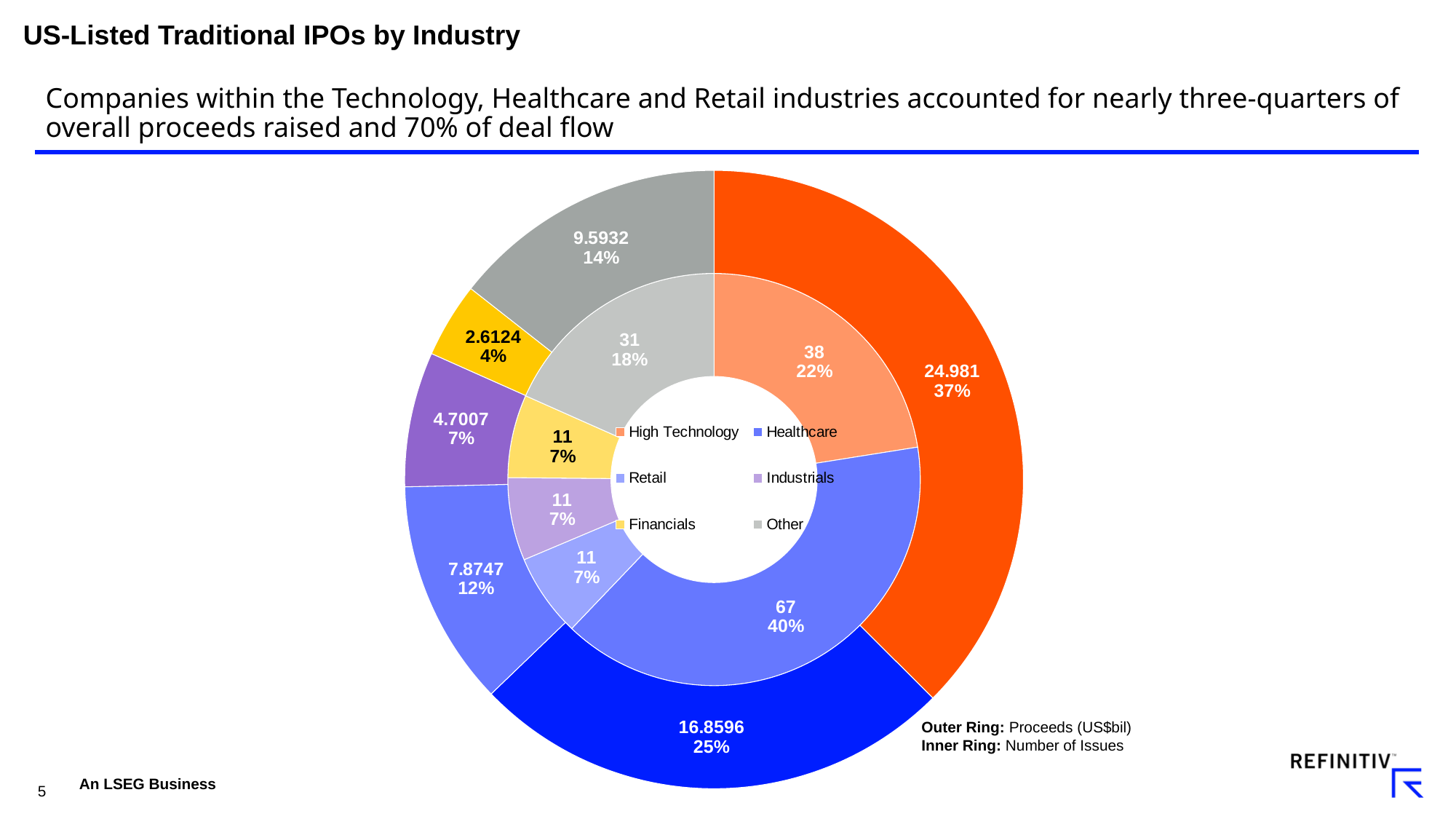
Which industry has the lowest proceeds in the outer ring? Financials What share of proceeds in the outer ring does Healthcare account for? 25% Which industry has the highest number of issues in the inner ring? Healthcare Which industry has the highest proceeds in the outer ring? High Technology What are the proceeds (US$bil) for High Technology in the outer ring? 24.981 Which has higher proceeds in the outer ring, Retail or Other? Other What type of chart is shown on the slide? Doughnut chart What share of the number of issues in the inner ring does Other account for? 18% How many industries does the legend list? 6 What is the difference in number of issues between Healthcare and High Technology in the inner ring? 29 What does the inner ring of the chart represent? Number of Issues How many issues does the inner ring show for Healthcare? 67